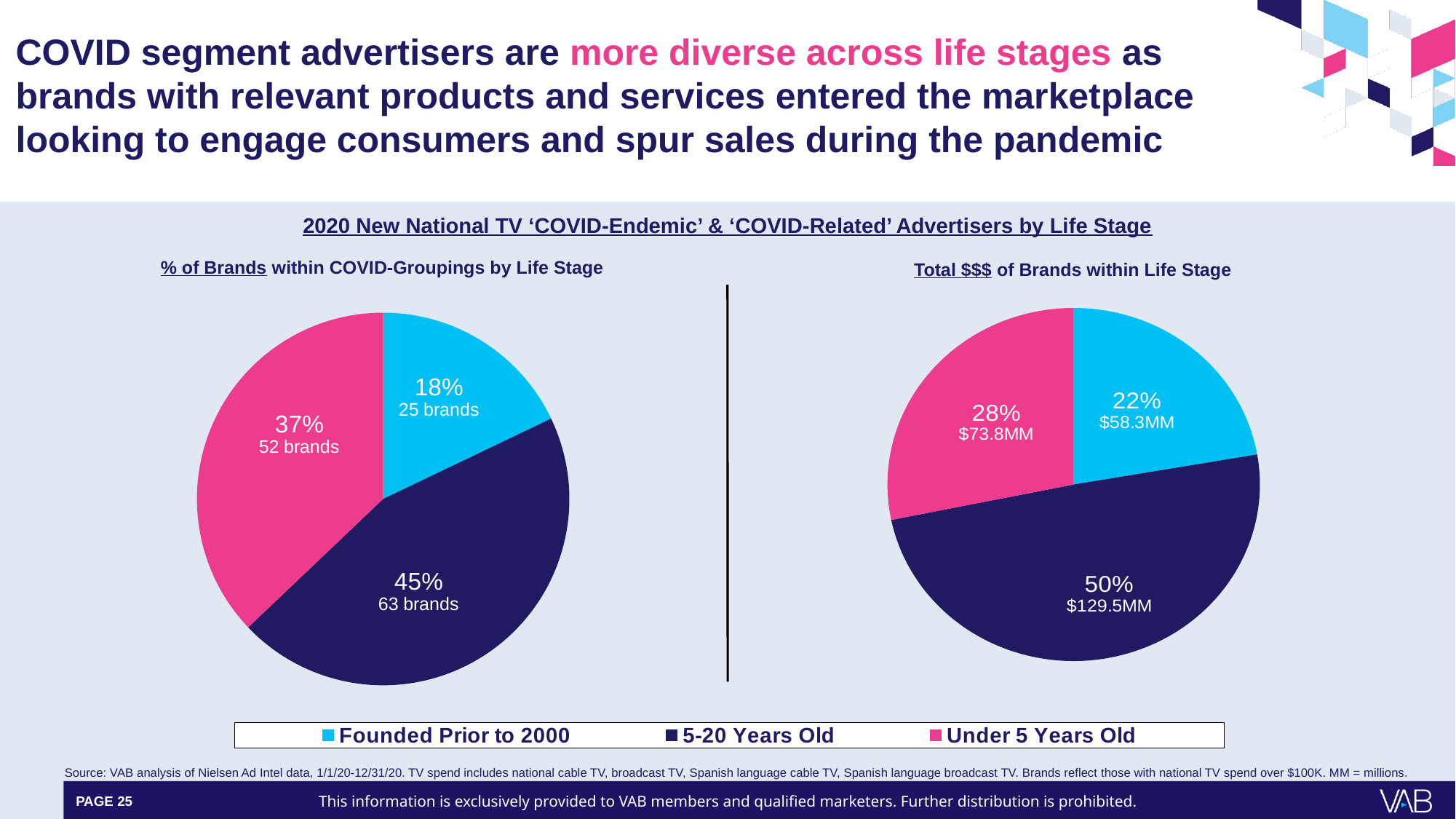
In the 'Total $$$ of Brands within Life Stage' pie chart, which life stage has the largest share of spend? 5-20 Years Old In the '% of Brands within COVID-Groupings by Life Stage' pie chart, how many brands are Under 5 Years Old? 52 brands In the '% of Brands within COVID-Groupings by Life Stage' pie chart, what share of brands are 5-20 Years Old? 45% In the 'Total $$$ of Brands within Life Stage' pie chart, what is the total spend for brands 5-20 Years Old? $129.5MM In the '% of Brands within COVID-Groupings by Life Stage' pie chart, which life stage has the smallest share? Founded Prior to 2000 In the 'Total $$$ of Brands within Life Stage' pie chart, what is the spend for brands Founded Prior to 2000? $58.3MM In the 'Total $$$ of Brands within Life Stage' pie chart, which is larger: spend for brands Under 5 Years Old or brands Founded Prior to 2000? Under 5 Years Old In the 'Total $$$ of Brands within Life Stage' pie chart, what share of spend comes from brands Under 5 Years Old? 28% In the '% of Brands within COVID-Groupings by Life Stage' pie chart, how many more brands are 5-20 Years Old than Under 5 Years Old? 11 brands How many categories does the legend list? 3 What type of chart is used on this slide? Pie chart In the '% of Brands within COVID-Groupings by Life Stage' pie chart, how many brands were Founded Prior to 2000? 25 brands